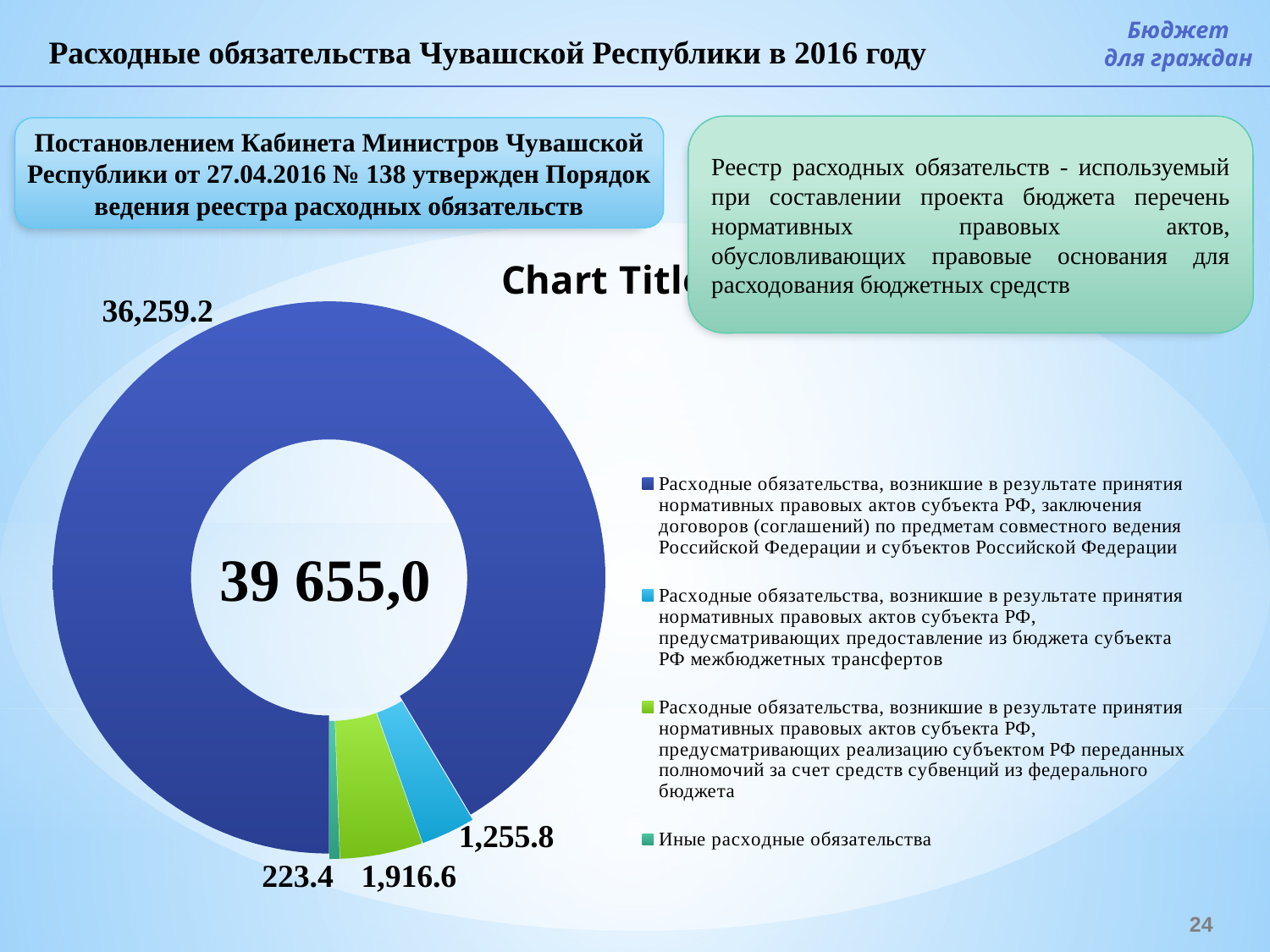
How many slices does the doughnut chart have? 4 What colour is the slice for 'Иные расходные обязательства' in the legend? Teal (dark green) What is the value of the green slice (обязательства, предусматривающие реализацию переданных полномочий за счет субвенций из федерального бюджета)? 1,916.6 What is the value of the largest slice of the doughnut chart? 36,259.2 What total value is printed in the centre of the doughnut chart? 39 655,0 Which category has the smallest slice in the doughnut chart? Иные расходные обязательства How many entries does the chart legend list? 4 What is the value of the light blue slice (обязательства, предусматривающие предоставление межбюджетных трансфертов)? 1,255.8 What kind of chart is shown on the slide? Doughnut (pie) chart Which is larger: the slice for межбюджетные трансферты or the slice for субвенции из федерального бюджета? Субвенции из федерального бюджета (1,916.6) What is the value for 'Иные расходные обязательства'? 223.4 What is the difference between the green slice (1,916.6) and the light blue slice (1,255.8)? 660.8